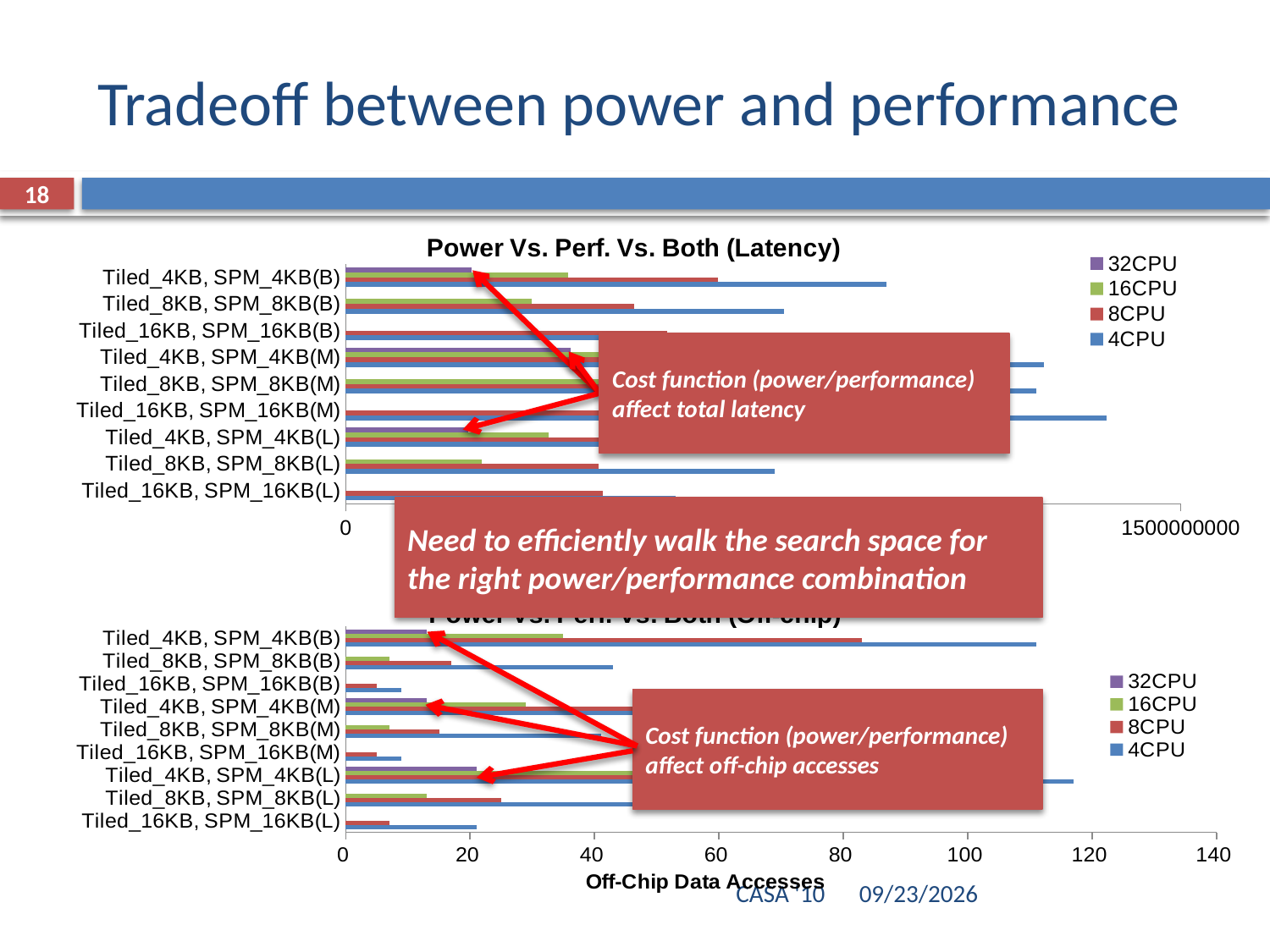
In the bottom chart, is the 4CPU value for Tiled_16KB, SPM_16KB(B) greater or less than 20? less In the bottom chart, is the 8CPU value for Tiled_8KB, SPM_8KB(L) greater or less than 20? greater In the bottom chart, is the 4CPU value for Tiled_4KB, SPM_4KB(L) greater or less than 100? greater How many series does the legend of the top chart, 'Power Vs. Perf. Vs. Both (Latency)', list? 4 What kind of chart is the top chart, 'Power Vs. Perf. Vs. Both (Latency)'? bar chart How many categories are shown on the y axis of the top chart, 'Power Vs. Perf. Vs. Both (Latency)'? 9 What is the title of the top chart on the slide? Power Vs. Perf. Vs. Both (Latency) How many series does the legend of the bottom chart list? 4 What is the x-axis title of the bottom chart on the slide? Off-Chip Data Accesses In the bottom chart, which has the larger 4CPU value: Tiled_4KB, SPM_4KB(B) or Tiled_16KB, SPM_16KB(B)? Tiled_4KB, SPM_4KB(B)